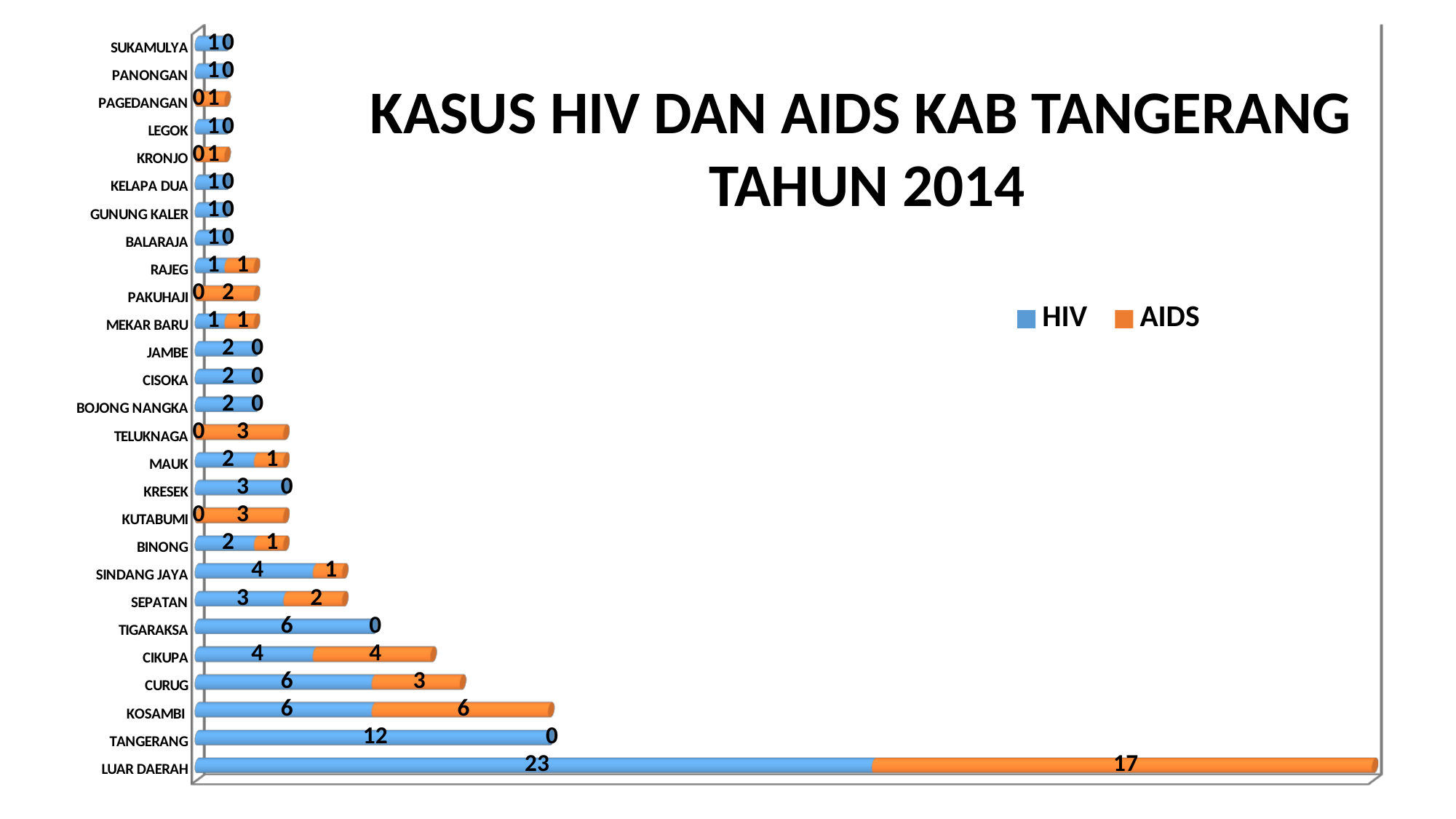
Which is larger, the HIV value for TANGERANG or the HIV value for KOSAMBI? TANGERANG What is the AIDS value for TELUKNAGA? 3 What type of chart is shown on the slide? Stacked bar chart How many categories are shown on the chart? 27 Which category has the highest AIDS value? LUAR DAERAH What is the AIDS value for KOSAMBI? 6 What is the total of the stacked bar for LUAR DAERAH? 40 What is the total of the stacked bar for CIKUPA? 8 What is the difference between the HIV and AIDS values for LUAR DAERAH? 6 What is the HIV value for LUAR DAERAH? 23 What is the HIV value for TANGERANG? 12 How many series does the legend list? 2